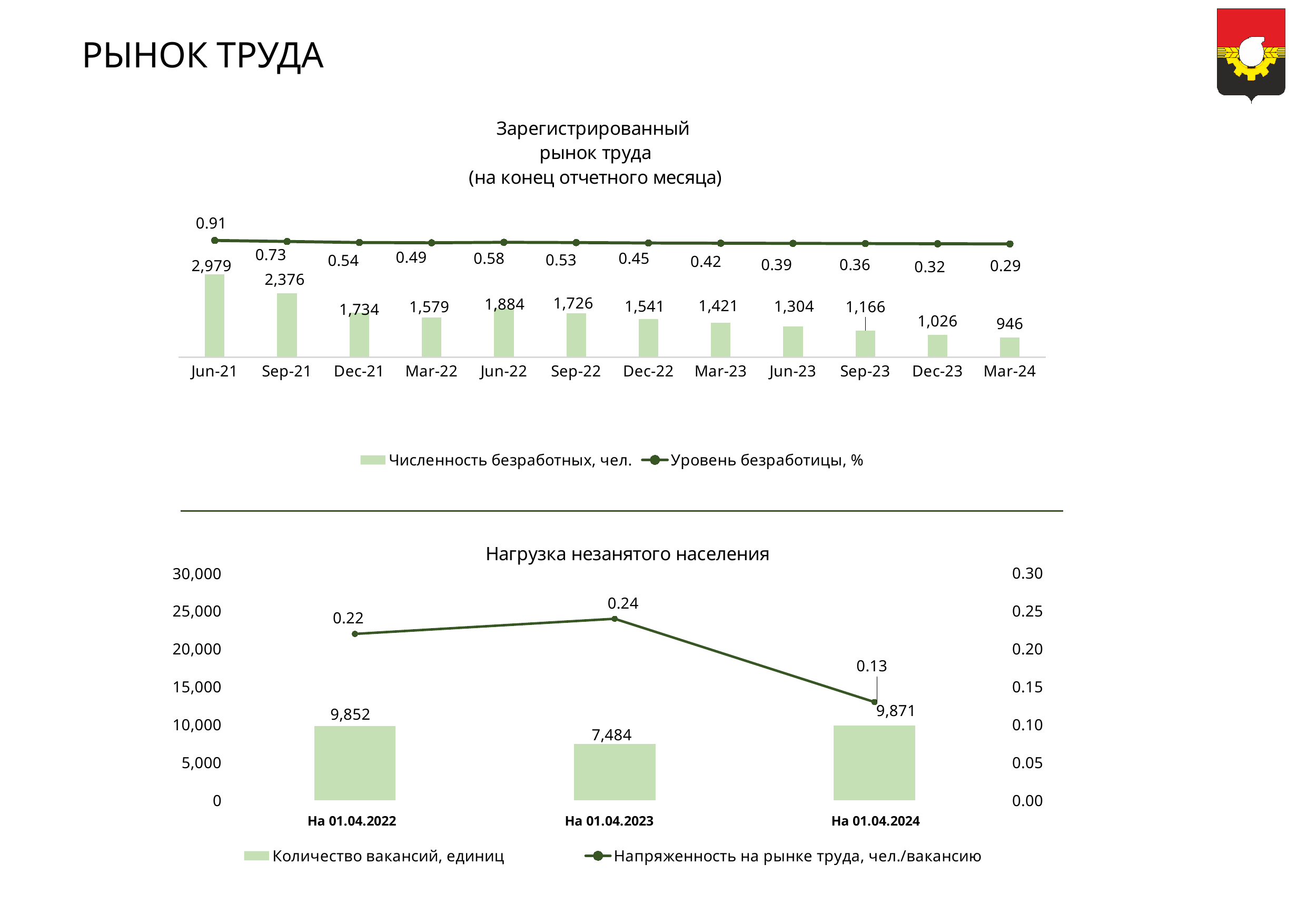
In the chart titled 'Зарегистрированный рынок труда (на конец отчетного месяца)', which period has the lowest 'Численность безработных, чел.'? Mar-24 In the chart titled 'Зарегистрированный рынок труда (на конец отчетного месяца)', how many periods are shown on the x axis? 12 In the chart titled 'Нагрузка незанятого населения', what kind of chart is used for 'Количество вакансий, единиц'? bar chart In the chart titled 'Зарегистрированный рынок труда (на конец отчетного месяца)', does 'Уровень безработицы, %' generally rise or fall from Jun-21 to Mar-24? fall In the chart titled 'Нагрузка незанятого населения', what is the value of 'Количество вакансий, единиц' for На 01.04.2023? 7,484 In the chart titled 'Зарегистрированный рынок труда (на конец отчетного месяца)', what is the value of 'Уровень безработицы, %' for Mar-24? 0.29 In the chart titled 'Зарегистрированный рынок труда (на конец отчетного месяца)', what is the difference in 'Численность безработных, чел.' between Jun-21 and Sep-21? 603 In the chart titled 'Зарегистрированный рынок труда (на конец отчетного месяца)', which is larger: 'Численность безработных, чел.' for Jun-22 or for Dec-21? Jun-22 In the chart titled 'Нагрузка незанятого населения', what is the difference in 'Количество вакансий, единиц' between На 01.04.2024 and На 01.04.2022? 19 In the chart titled 'Нагрузка незанятого населения', how many series does the legend list? 2 In the chart titled 'Нагрузка незанятого населения', which date has the highest 'Напряженность на рынке труда, чел./вакансию'? На 01.04.2023 In the chart titled 'Зарегистрированный рынок труда (на конец отчетного месяца)', what is the value of 'Численность безработных, чел.' for Jun-21? 2,979